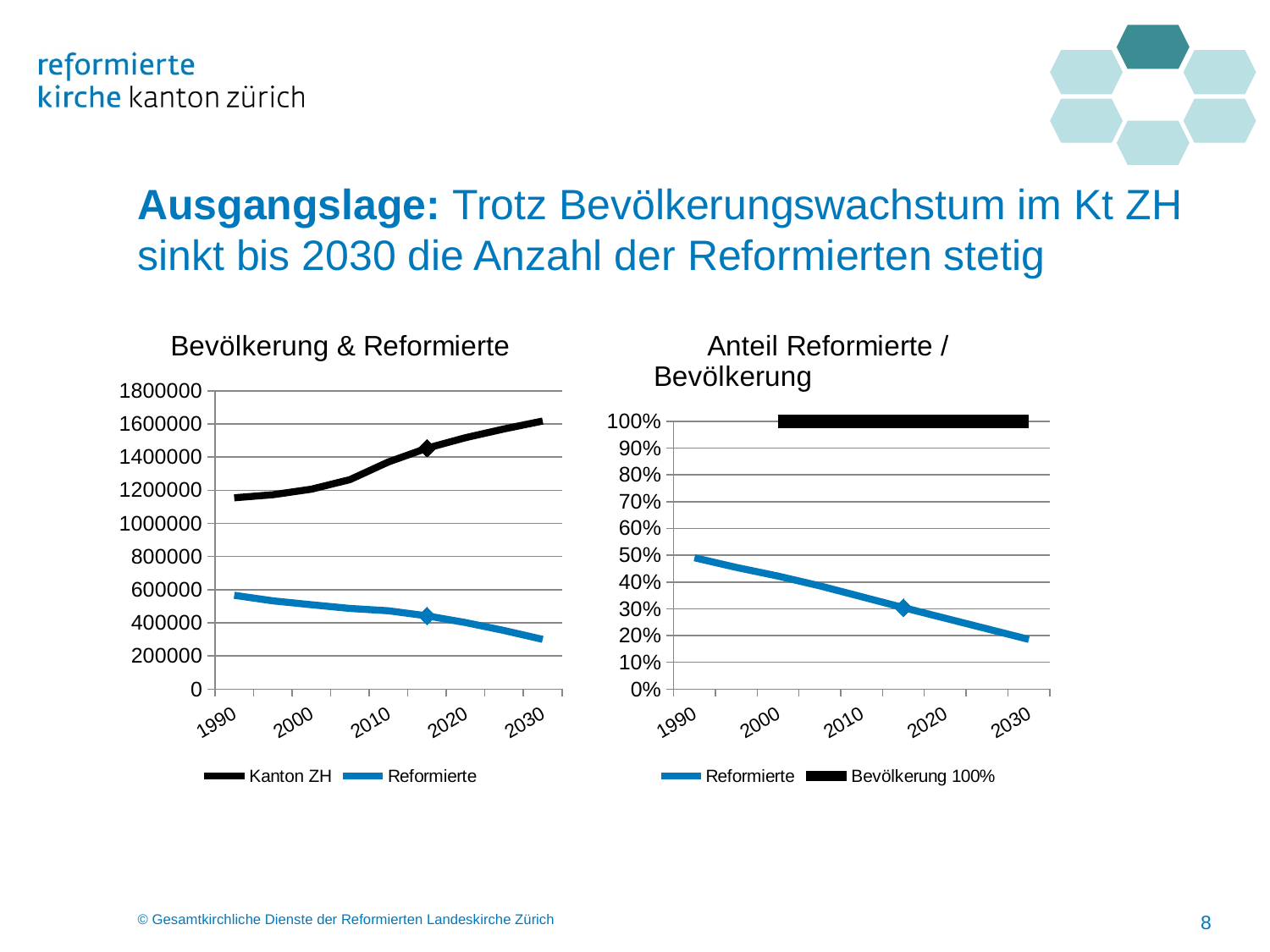
In the chart titled "Bevölkerung & Reformierte", which series has the larger value in 2030, Kanton ZH or Reformierte? Kanton ZH In the chart titled "Bevölkerung & Reformierte", does the Kanton ZH line rise or fall from 1990 to 2030? rise In the chart titled "Bevölkerung & Reformierte", is the value for Kanton ZH in 1990 greater or less than 1000000? greater In the chart titled "Anteil Reformierte / Bevölkerung", is the value for Reformierte in 1990 greater or less than 60%? less How many year labels are shown on the x axis of the chart titled "Anteil Reformierte / Bevölkerung"? 5 In the chart titled "Anteil Reformierte / Bevölkerung", does the Reformierte line rise or fall from 1990 to 2030? fall In the chart titled "Bevölkerung & Reformierte", is the value for Reformierte in 2030 greater or less than 400000? less In the chart titled "Bevölkerung & Reformierte", does the Reformierte line rise or fall from 1990 to 2030? fall What kind of chart is the chart titled "Bevölkerung & Reformierte"? line chart What are the two legend entries of the chart titled "Anteil Reformierte / Bevölkerung"? Reformierte and Bevölkerung 100% How many series does the legend of the chart titled "Bevölkerung & Reformierte" list? 2